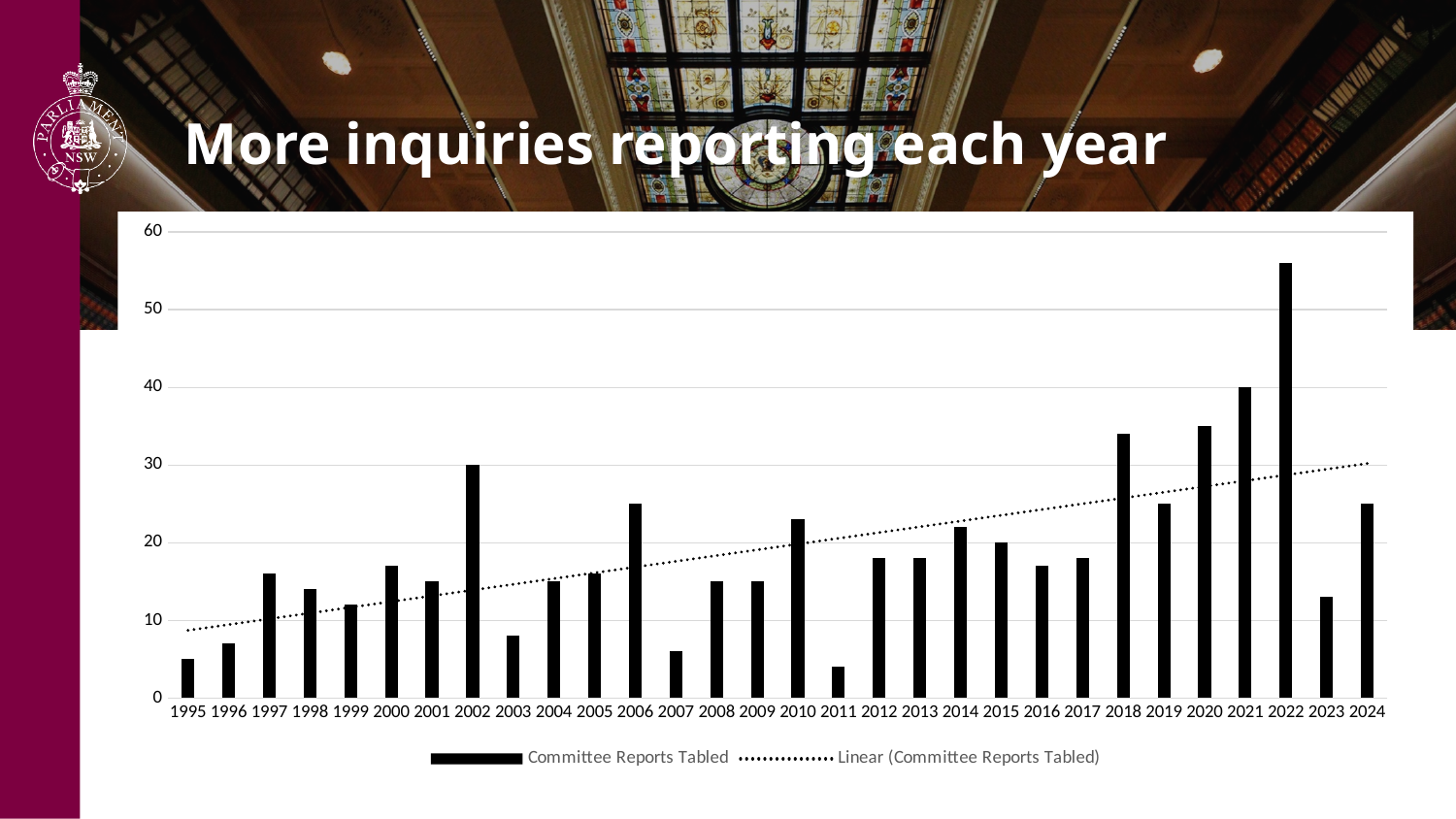
Is the value for 2018 greater or less than 30? greater How many years are shown on the x axis? 30 Does the linear trend line rise or fall from 1995 to 2024? rise What is the title of the slide? More inquiries reporting each year What kind of chart is shown on the slide? bar chart How many series does the legend list? 2 Which year has the highest number of committee reports tabled? 2022 Which year has more committee reports tabled, 2020 or 2019? 2020 Is the value for 2011 greater or less than 10? less Which year has more committee reports tabled, 2006 or 2005? 2006 Is the value for 2007 greater or less than 10? less